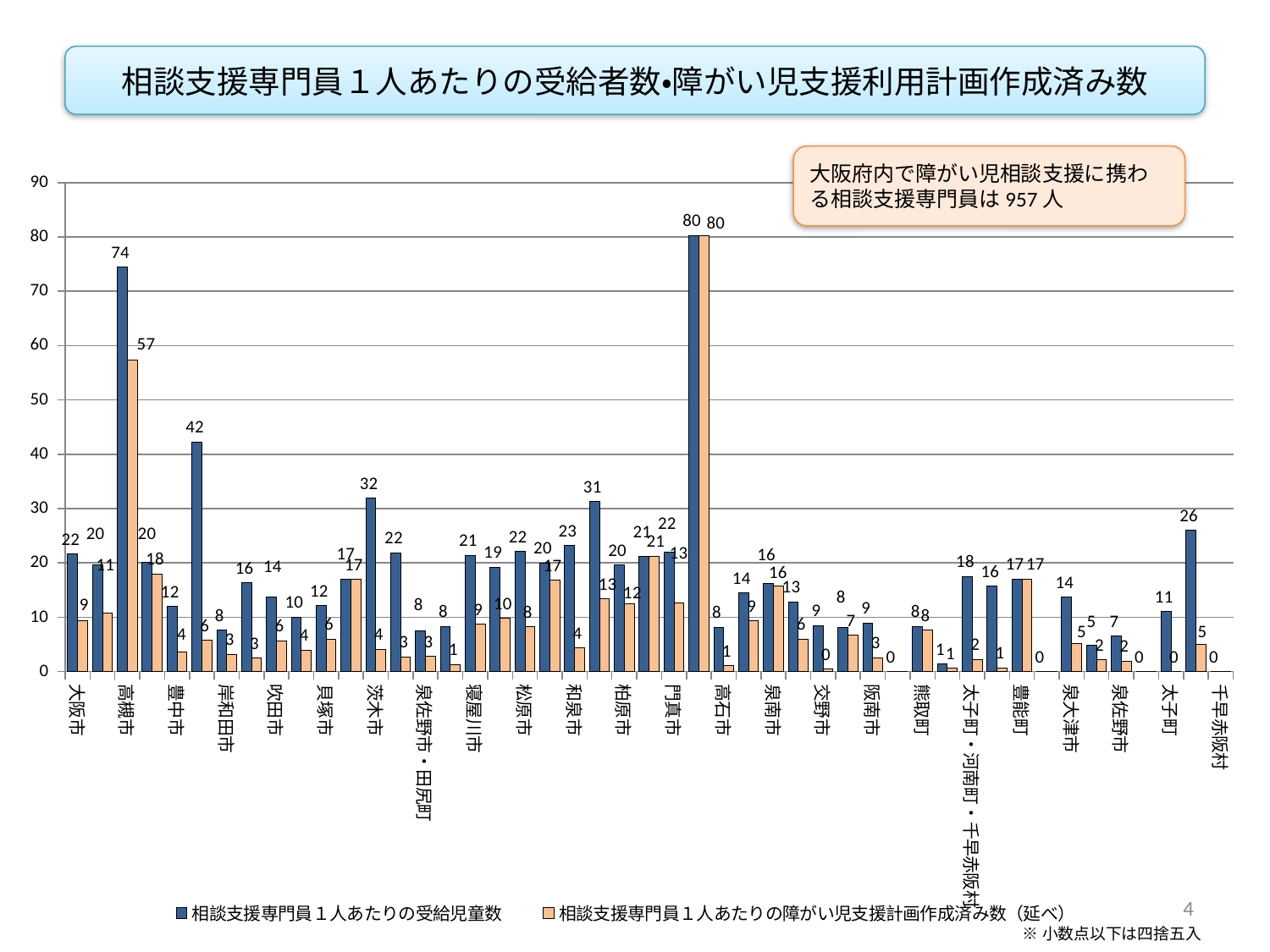
What is the value of 相談支援専門員１人あたりの受給児童数 for 大阪市? 22 For 高槻市, which series has the larger value: 相談支援専門員１人あたりの受給児童数 or 相談支援専門員１人あたりの障がい児支援計画作成済み数（延べ）? 相談支援専門員１人あたりの受給児童数 What is the difference between the two series values for 高槻市? 17 What is the value of 相談支援専門員１人あたりの受給児童数 for 高槻市? 74 Is the value of 相談支援専門員１人あたりの受給児童数 for 高槻市 greater or less than 70? greater How many series does the legend list? 2 What is the highest value shown for the 相談支援専門員１人あたりの受給児童数 series? 80 What is the value of 相談支援専門員１人あたりの受給児童数 for 茨木市? 32 What is the title of the chart? 相談支援専門員１人あたりの受給者数•障がい児支援利用計画作成済み数 What kind of chart is shown on the slide? bar chart What is the value of 相談支援専門員１人あたりの障がい児支援計画作成済み数（延べ） for 高槻市? 57 What is the highest value shown on the vertical axis? 90